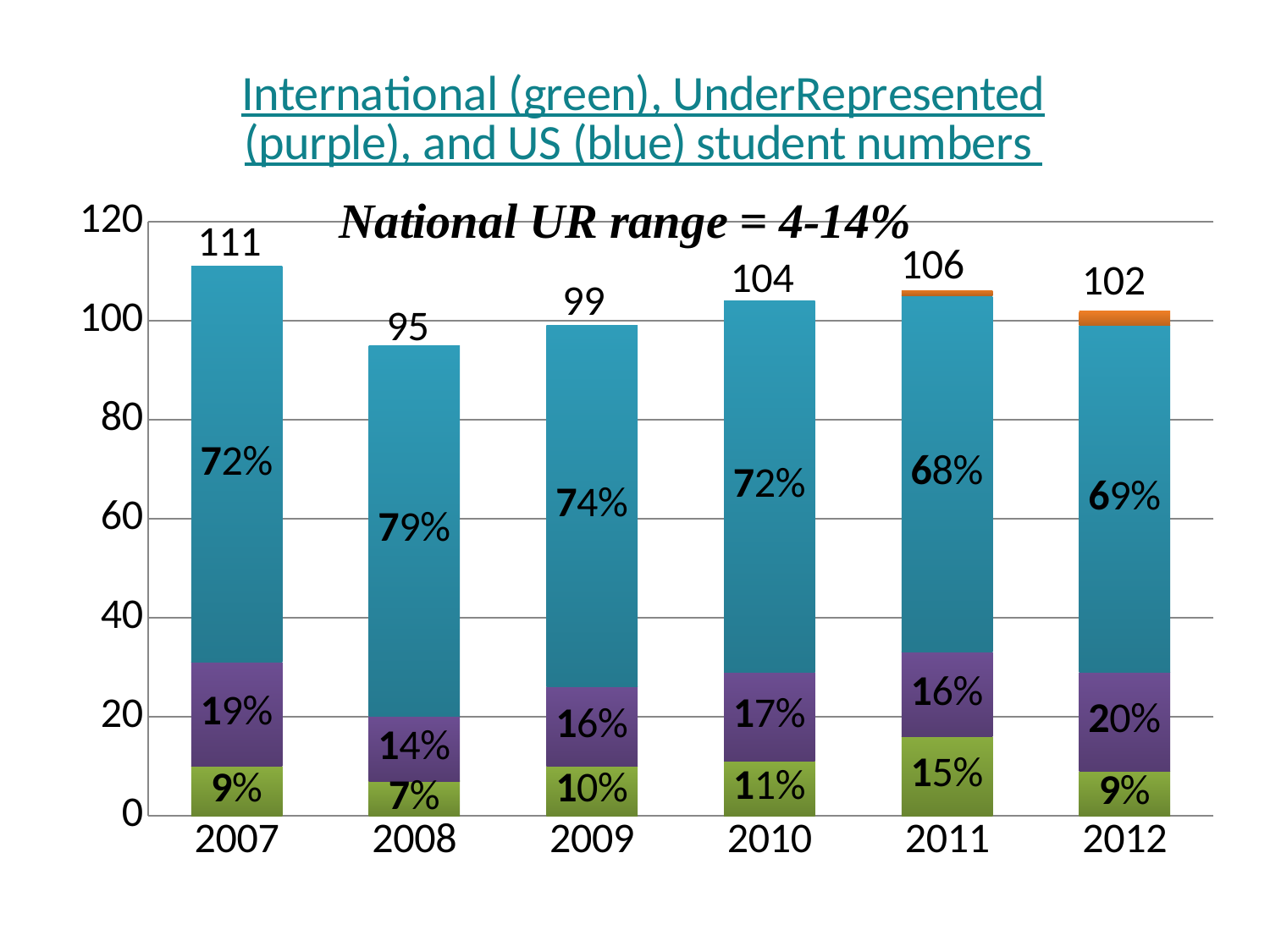
Which year has the highest total student number? 2007 What percentage is labelled on the green (International) segment of the 2011 bar? 15% What is the total student number shown above the bar for 2007? 111 Which year has the larger total student number, 2010 or 2012? 2010 What text is written inside the plot area near the top of the chart? National UR range = 4-14% What percentage is labelled on the purple (UnderRepresented) segment of the 2012 bar? 20% What kind of chart is shown on the slide? stacked bar chart What is the difference between the total student numbers for 2007 and 2008? 16 Is the total student number for 2009 greater or less than 100? less Which year has the lowest total student number? 2008 How many years are shown on the x axis? 6 What percentage is labelled on the blue (US) segment of the 2008 bar? 79%